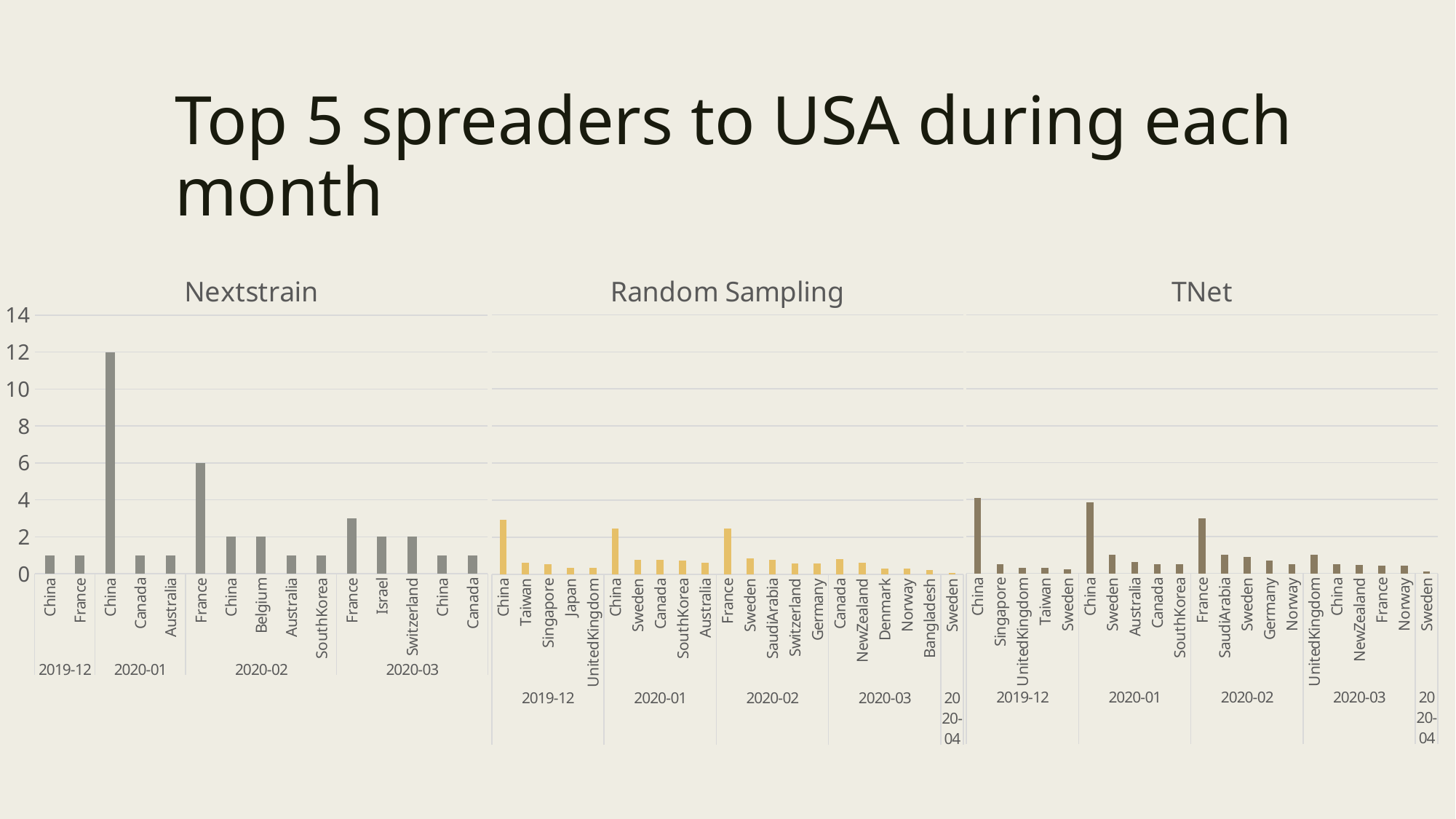
In the Random Sampling chart, is the value for China in 2019-12 greater or less than 2? greater What are the titles of the three charts on the slide? Nextstrain, Random Sampling, TNet In the TNet chart, is the value for Taiwan in 2019-12 greater or less than 2? less In the Nextstrain chart, which bar is the highest? China (2020-01) In the Nextstrain chart, what is the value for France in 2020-02? 6 In the Nextstrain chart, which is larger: France in 2020-02 or France in 2020-03? France in 2020-02 In the Nextstrain chart, what is the difference between China in 2020-01 and France in 2020-02? 6 In the Random Sampling chart, which bar is the highest? China (2019-12) How many bars are plotted in the Nextstrain chart? 15 In the Nextstrain chart, what is the value for China in 2020-01? 12 What kind of chart is the TNet chart? bar chart